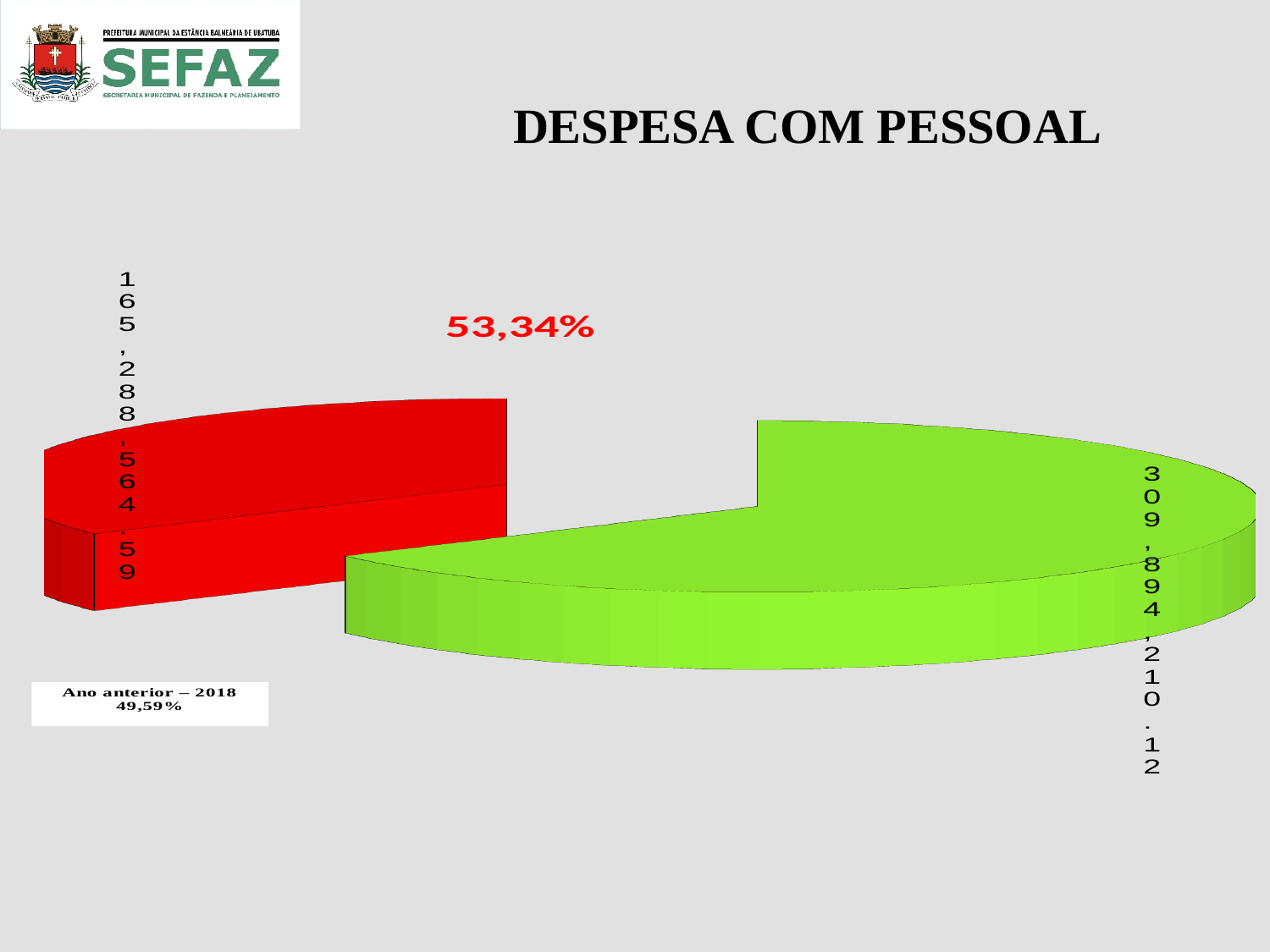
Which slice of the pie chart is the smallest? the red slice What percentage is printed in red text above the pie chart? 53,34% Which is larger, the value of the green slice or the value of the red slice? the green slice What value is labelled on the green slice of the pie chart? 309,894,210.12 What value is labelled on the red slice of the pie chart? 165,288,564.59 What is the difference between the green slice value and the red slice value? 144,605,645.53 How many slices does the pie chart have? 2 What kind of chart is shown on the slide? pie chart What is the title of the chart? DESPESA COM PESSOAL What is the total of the two slice values in the pie chart? 475,182,774.71 Which slice of the pie chart is the largest? the green slice